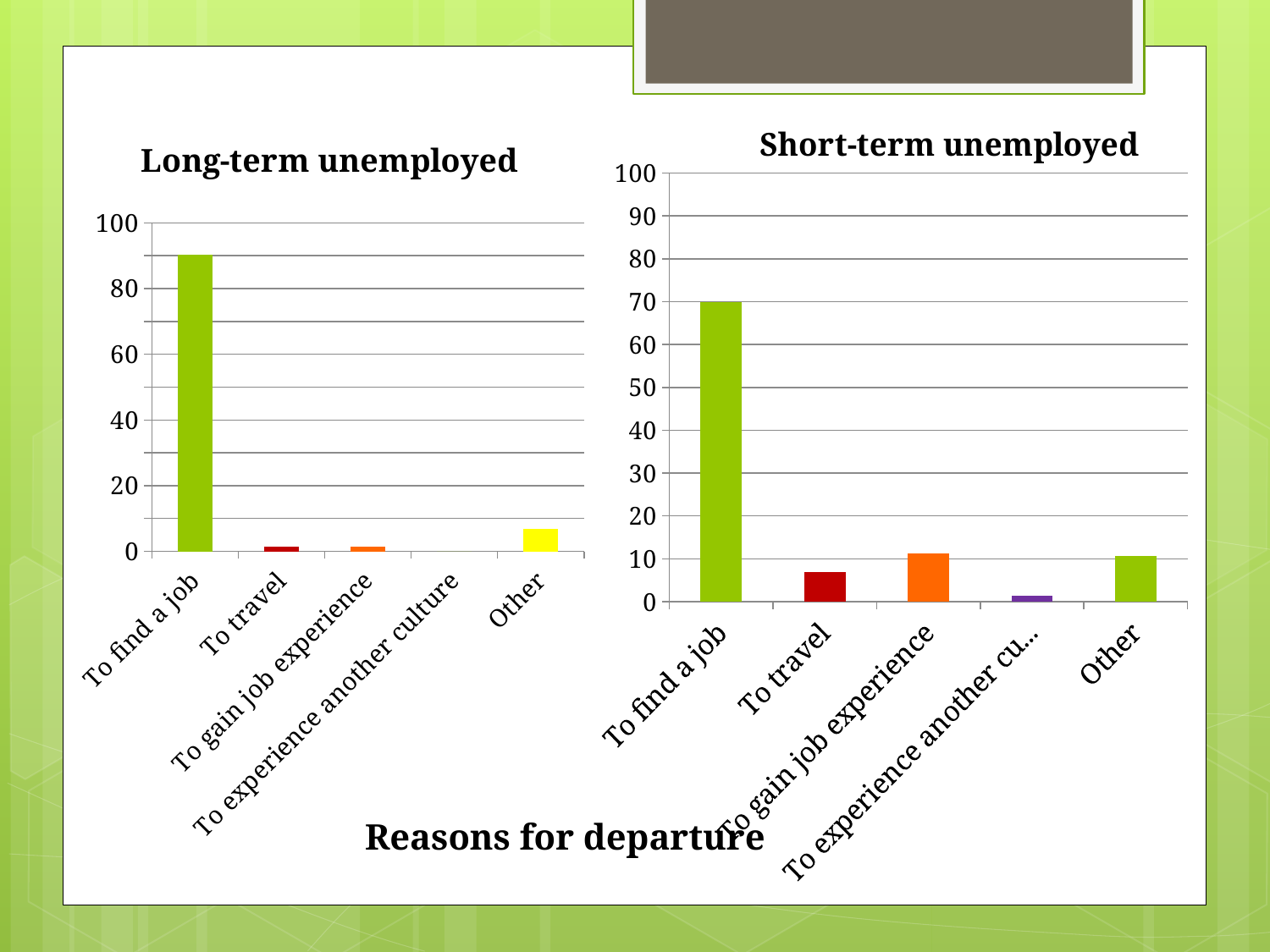
In the Long-term unemployed chart, is the value for To find a job greater or less than 80? greater In the Short-term unemployed chart, is the value for To gain job experience greater or less than 20? less In the Long-term unemployed chart, is the value for Other greater or less than 20? less In the Short-term unemployed chart, which reason has the highest value? To find a job In the Short-term unemployed chart, which is larger, the value for To travel or the value for To gain job experience? To gain job experience What kind of chart is the Short-term unemployed chart? bar chart How many reasons are shown on the x axis of the Long-term unemployed chart? 5 In the Short-term unemployed chart, which reason has the lowest value? To experience another culture What is the shared x-axis label printed below the two charts? Reasons for departure In the Long-term unemployed chart, which reason has the highest value? To find a job